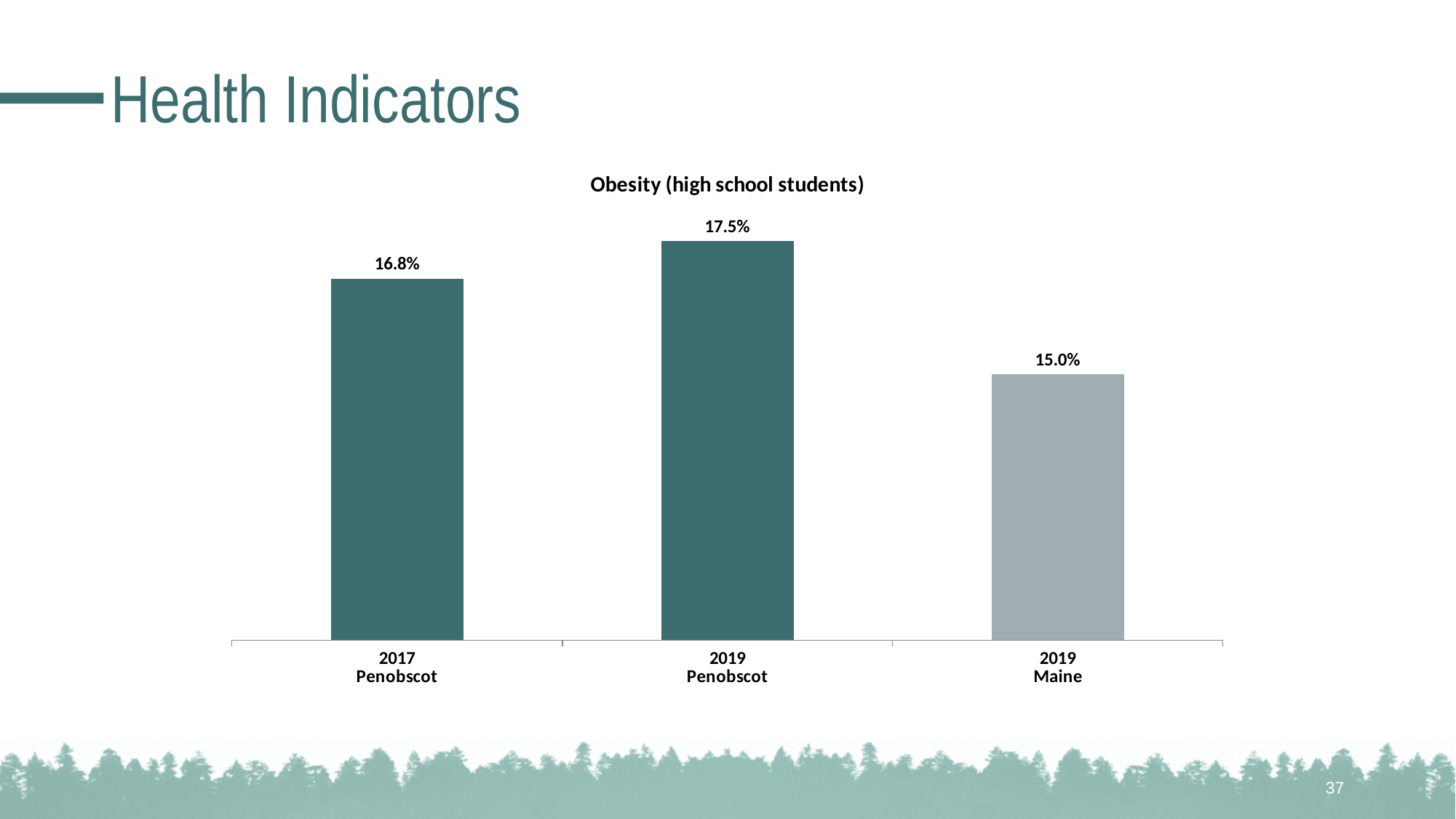
Which is larger, the obesity rate for 2017 Penobscot or 2019 Maine? 2017 Penobscot What is the difference between the 2019 Penobscot and 2017 Penobscot obesity rates? 0.7% What is the title of the chart? Obesity (high school students) What is the difference between the 2019 Penobscot and 2019 Maine obesity rates? 2.5% Which category has the lowest obesity rate? 2019 Maine What is the obesity rate for 2019 Penobscot? 17.5% What kind of chart is shown on the slide? Bar chart What is the obesity rate for 2017 Penobscot? 16.8% What is the obesity rate for 2019 Maine? 15.0% How many bars are shown in the chart? 3 Did the Penobscot obesity rate rise or fall from 2017 to 2019? Rise Which category has the highest obesity rate? 2019 Penobscot